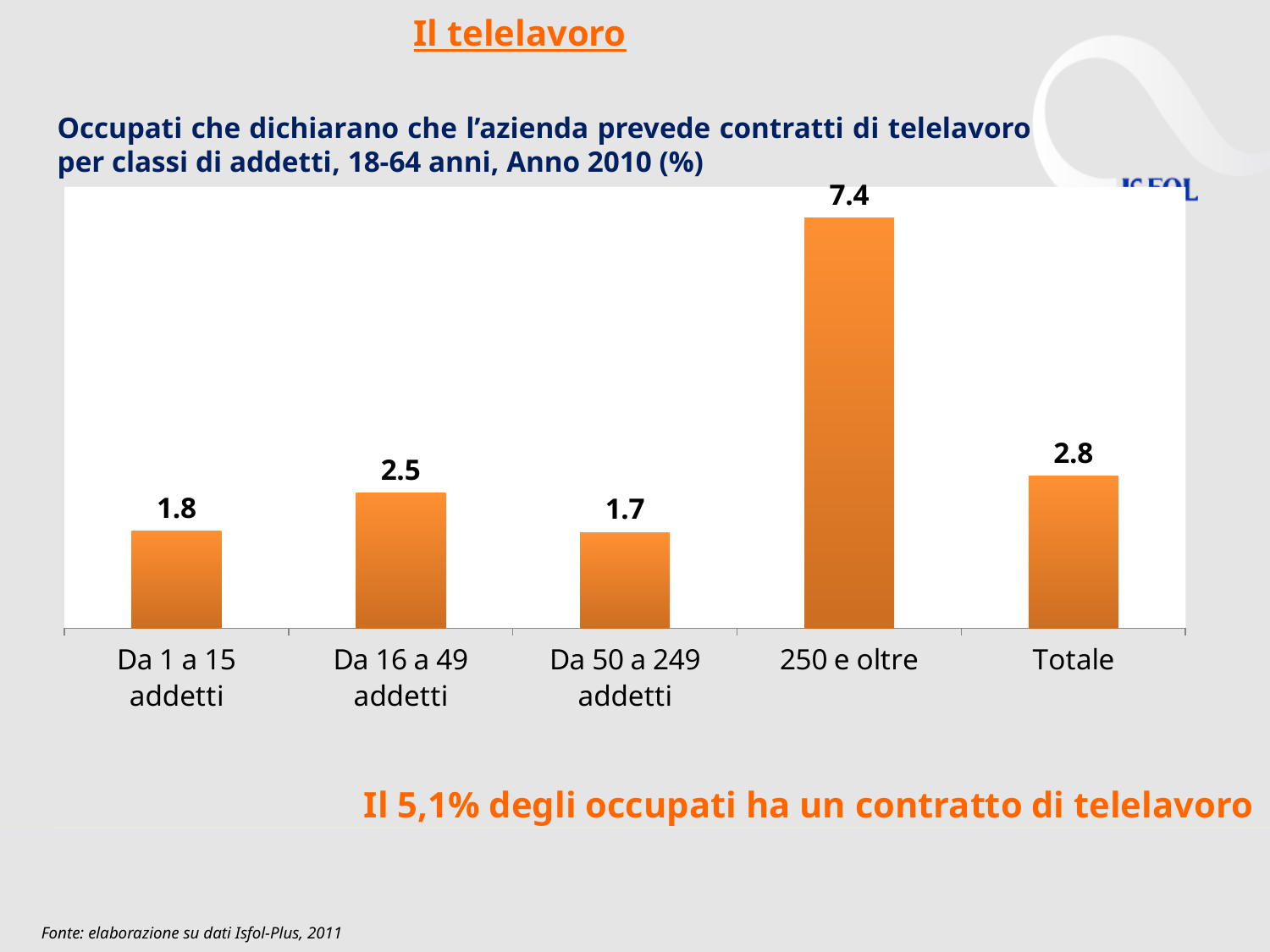
What is the value for "250 e oltre"? 7.4 What is the source cited at the bottom of the slide? Fonte: elaborazione su dati Isfol-Plus, 2011 What kind of chart is shown on the slide? Bar chart What is the value for "Da 16 a 49 addetti"? 2.5 How many categories are shown on the x axis? 5 What is the value for "Da 1 a 15 addetti"? 1.8 Which is larger, the value for "Da 16 a 49 addetti" or the value for "Da 1 a 15 addetti"? Da 16 a 49 addetti Which category has the highest value? 250 e oltre What is the difference between the values for "250 e oltre" and "Totale"? 4.6 What is the value for "Totale"? 2.8 Which category has the lowest value? Da 50 a 249 addetti What is the value for "Da 50 a 249 addetti"? 1.7